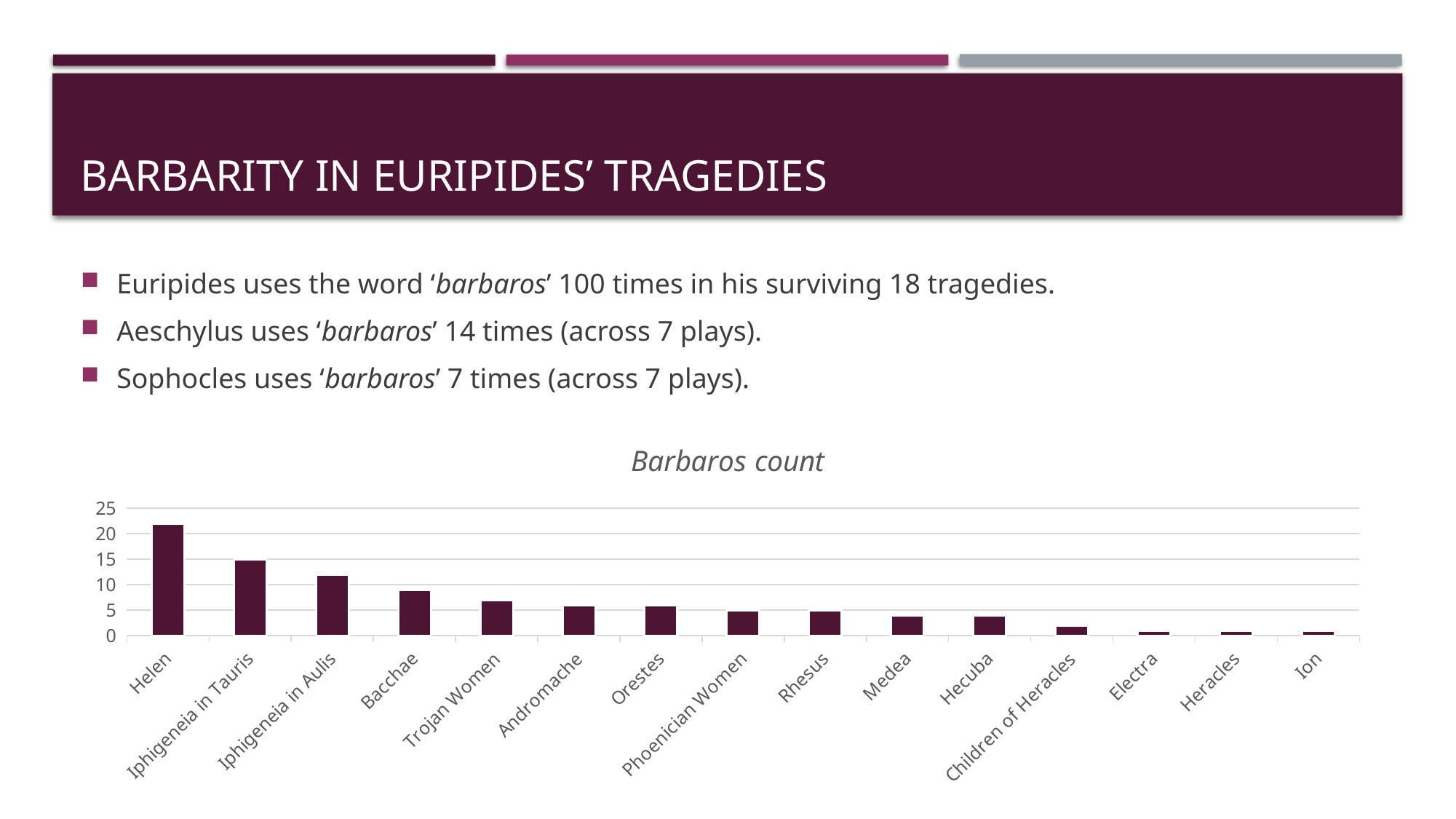
Is the value for Helen greater or less than 20? greater What type of chart is shown on the slide? bar chart Is the value for Iphigeneia in Tauris greater or less than 10? greater Do the values generally rise or fall moving from left to right along the x axis? fall Is the value for Children of Heracles greater or less than 5? less Which has a higher barbaros count, Medea or Iphigeneia in Aulis? Iphigeneia in Aulis How many plays are shown on the x axis of the chart? 15 Which has a higher barbaros count, Helen or Bacchae? Helen Which play has the highest barbaros count in the chart? Helen What is the title of the chart? Barbaros count